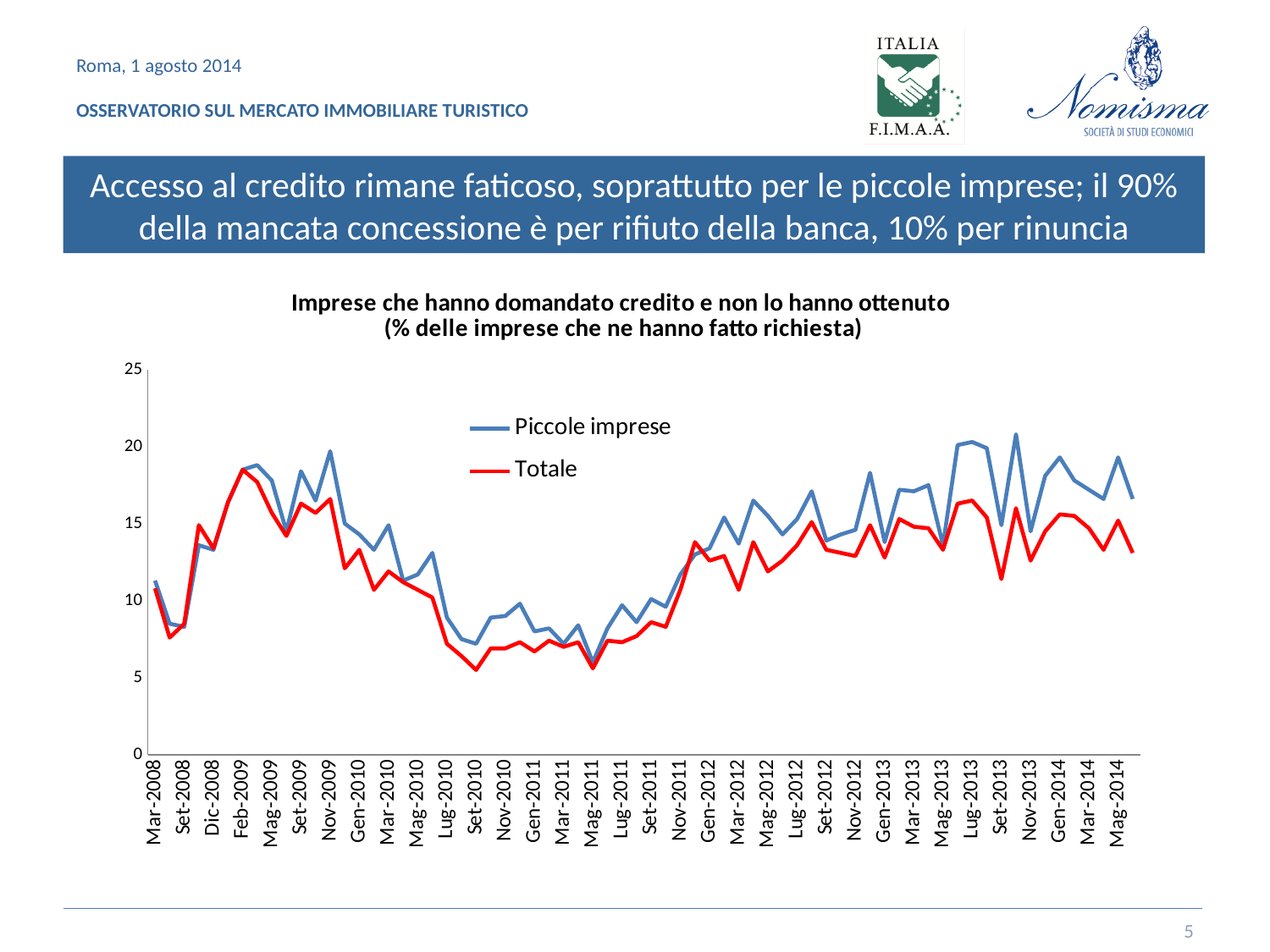
Is the value for Totale at Feb-2009 greater or less than 15? greater Is the value for Totale at Set-2010 greater or less than 10? less What are the two series named in the legend? Piccole imprese and Totale What kind of chart is shown on the slide? line chart Is the value for Totale at Mag-2014 greater or less than 10? greater At Set-2013, which series has the higher value, Piccole imprese or Totale? Piccole imprese Does the Piccole imprese line rise or fall between Feb-2009 and Set-2010? fall Which colour is used for the Totale series? red How many series does the legend list? 2 Does the Totale line rise or fall overall between Set-2010 and Lug-2013? rise